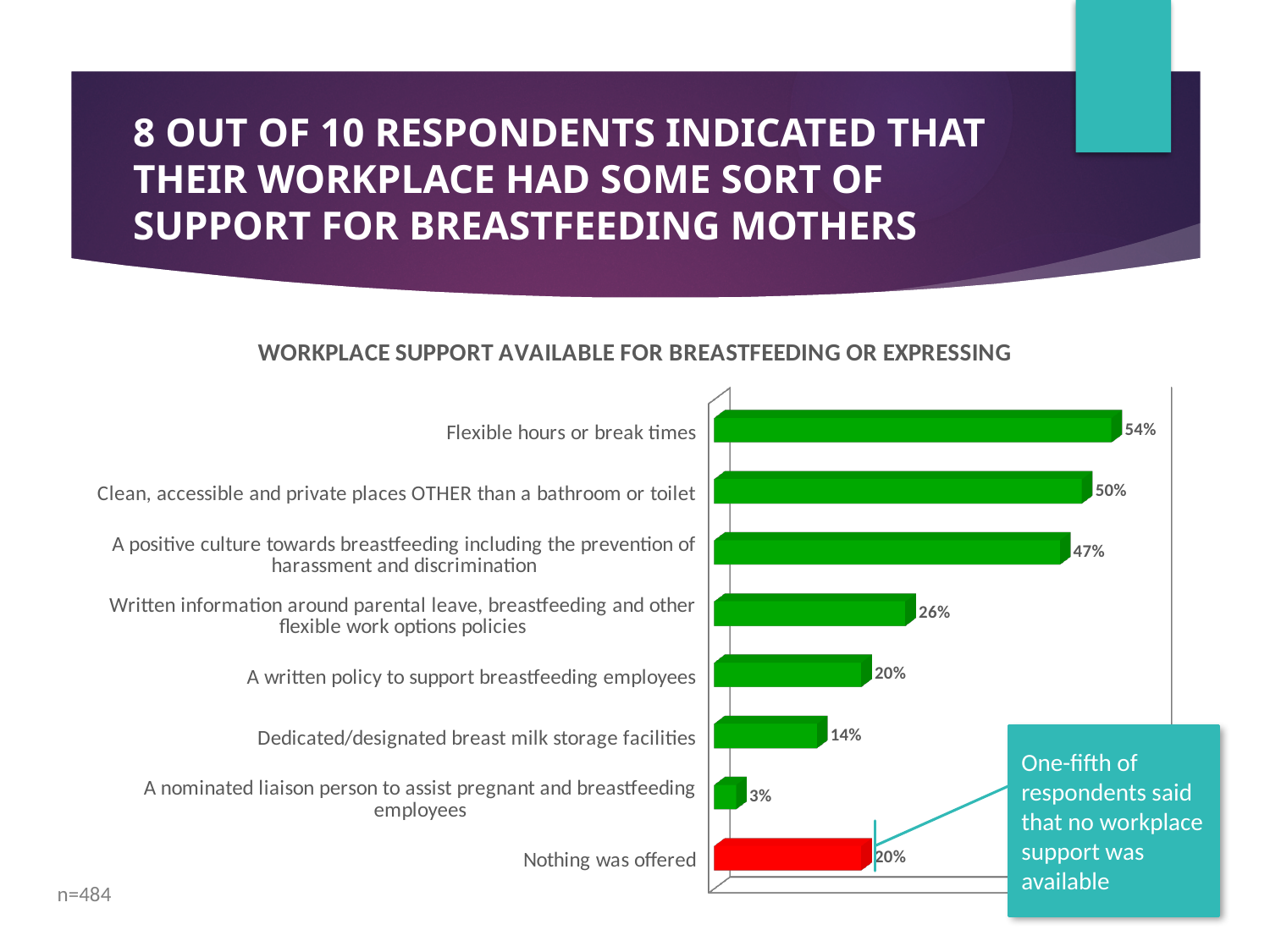
What percentage is shown for 'Dedicated/designated breast milk storage facilities'? 14% What is the difference between 'Flexible hours or break times' and 'Clean, accessible and private places OTHER than a bathroom or toilet'? 4% How many categories are shown in the chart? 8 Which category has the lowest value? A nominated liaison person to assist pregnant and breastfeeding employees Which category has the highest value? Flexible hours or break times What percentage of respondents indicated 'Flexible hours or break times' was available? 54% What is the value for 'A written policy to support breastfeeding employees'? 20% What kind of chart is shown on the slide? Bar chart What is the title of the chart? WORKPLACE SUPPORT AVAILABLE FOR BREASTFEEDING OR EXPRESSING What is the value for 'Nothing was offered'? 20% Which is larger: the value for 'Written information around parental leave, breastfeeding and other flexible work options policies' or the value for 'Dedicated/designated breast milk storage facilities'? Written information around parental leave, breastfeeding and other flexible work options policies Which bar is coloured red rather than green? Nothing was offered